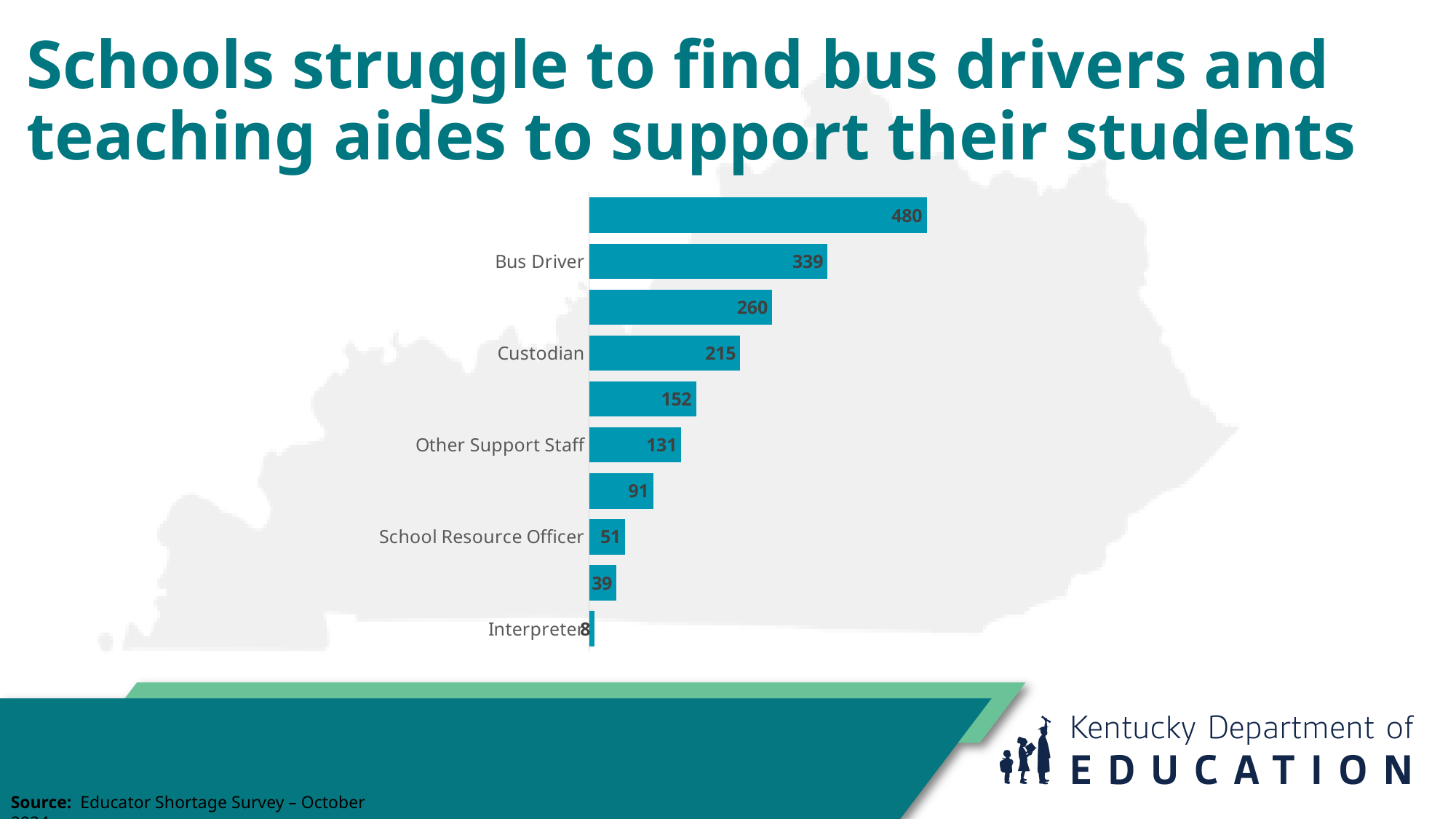
Which labeled category has the lowest value? Interpreter Which is larger, the value for Custodian or the value for Other Support Staff? Custodian What is the value for Interpreter? 8 What is the value for Bus Driver? 339 What is the value for Other Support Staff? 131 How many bars are plotted in the chart? 10 What is the largest value shown on any bar in the chart? 480 What is the difference between the values for Bus Driver and Custodian? 124 What is the value for School Resource Officer? 51 What is the value for Custodian? 215 What kind of chart is shown on the slide? Bar chart What is the difference between the values for Other Support Staff and School Resource Officer? 80